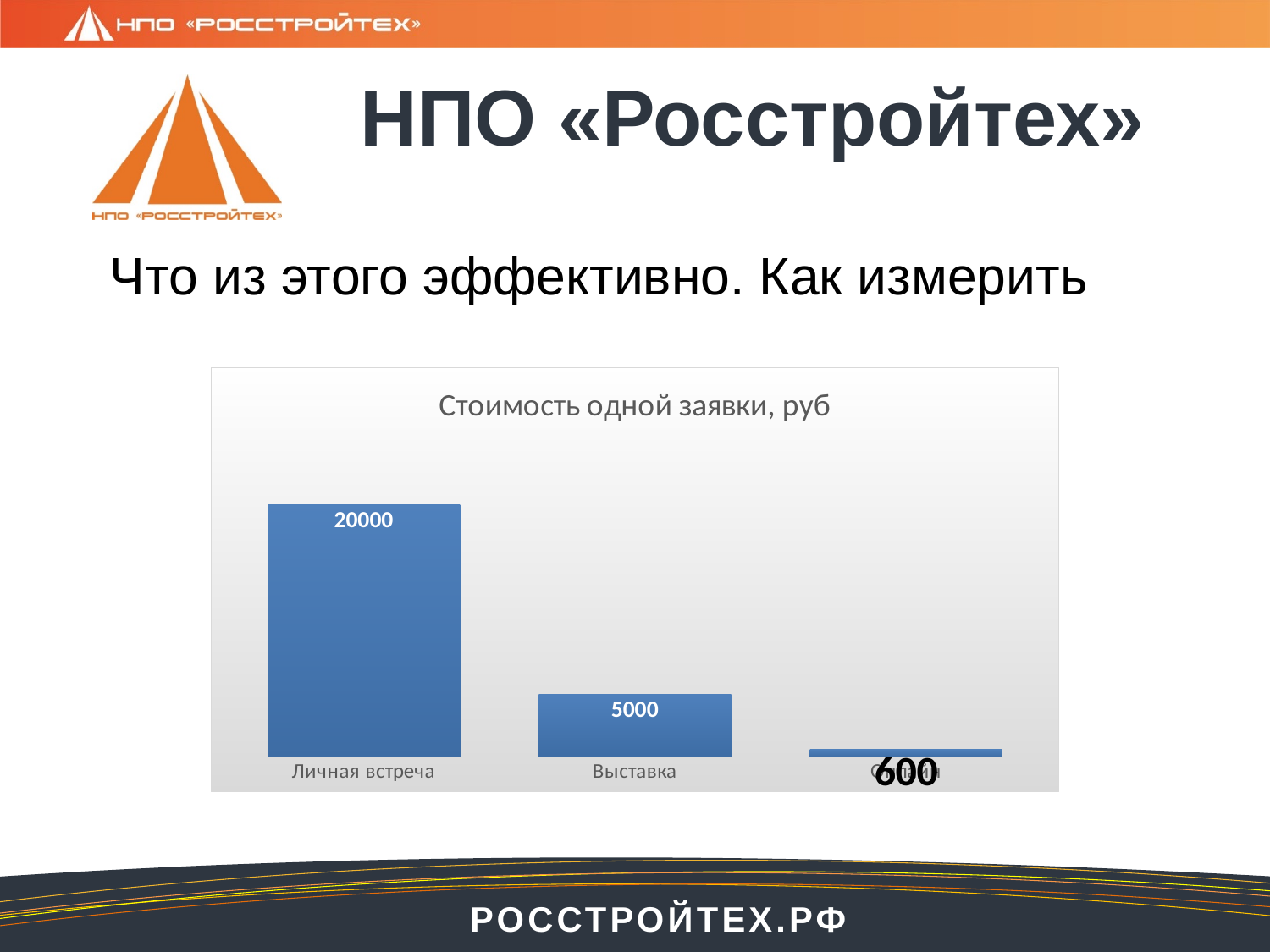
What is the value for Выставка? 5000 How many bars are plotted in the chart? 3 What colour are the bars in the chart? blue What type of chart is shown on the slide? bar chart What is the title of the chart? Стоимость одной заявки, руб Do the values rise or fall from left to right along the x axis? fall What is the value for Личная встреча? 20000 Which is larger, the value for Личная встреча or the value for Выставка? Личная встреча Which category has the highest value? Личная встреча What is the difference between the values for Личная встреча and Выставка? 15000